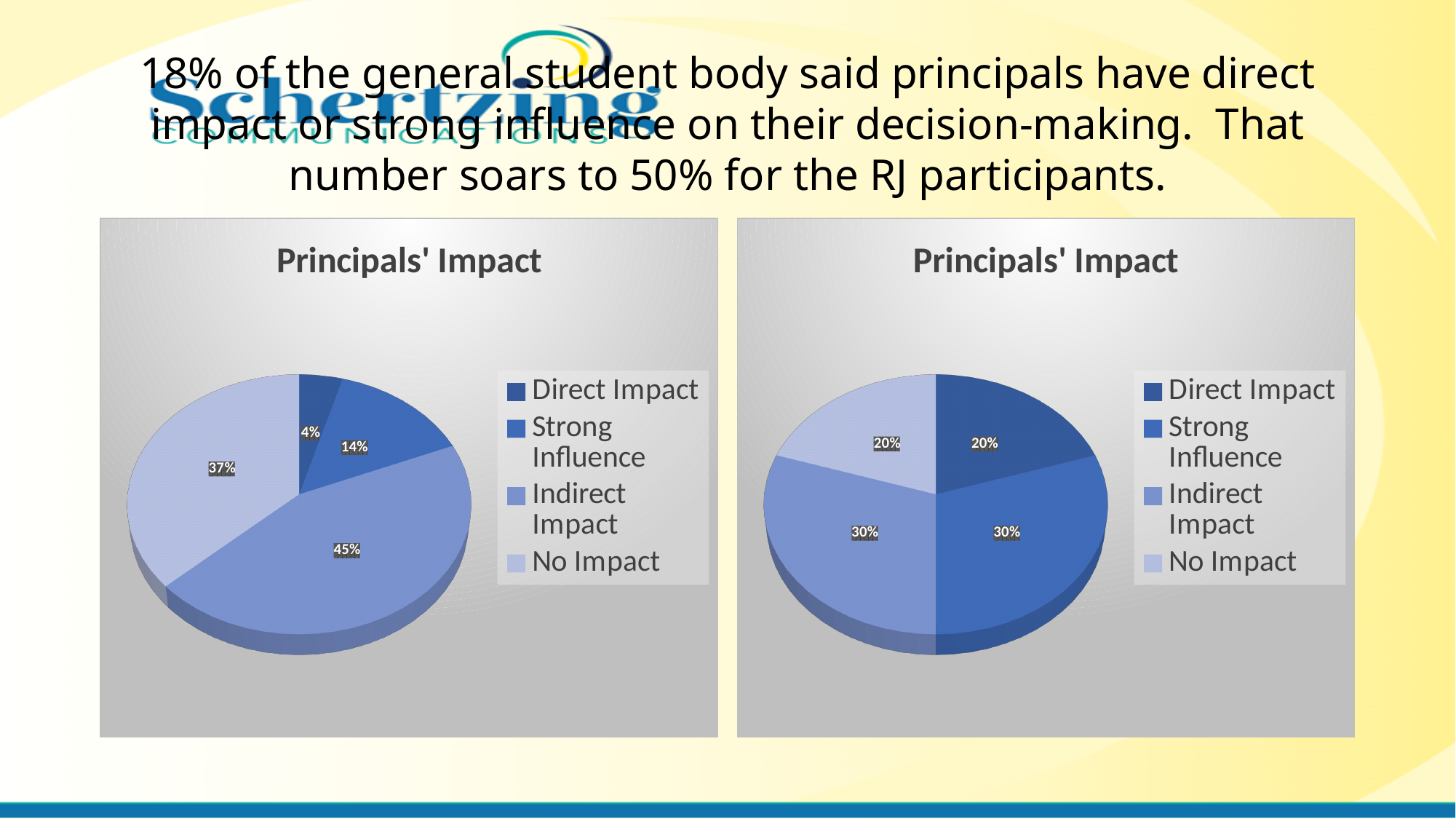
What type of chart is the left chart? Pie chart In the left pie chart, what is the difference between the No Impact and Strong Influence percentages? 23% In the left pie chart, which category has the smallest slice? Direct Impact In the right pie chart, what percentage is shown for Strong Influence? 30% In the left pie chart, what percentage is shown for Indirect Impact? 45% In the left pie chart, what percentage is shown for Direct Impact? 4% Which is larger in the left pie chart: No Impact or Indirect Impact? Indirect Impact In the left pie chart, which category has the largest slice? Indirect Impact In the right pie chart, what is the difference between the Indirect Impact and Direct Impact percentages? 10% How many slices does the right pie chart have? 4 What is the title of the right chart? Principals' Impact In the right pie chart, what percentage is shown for No Impact? 20%